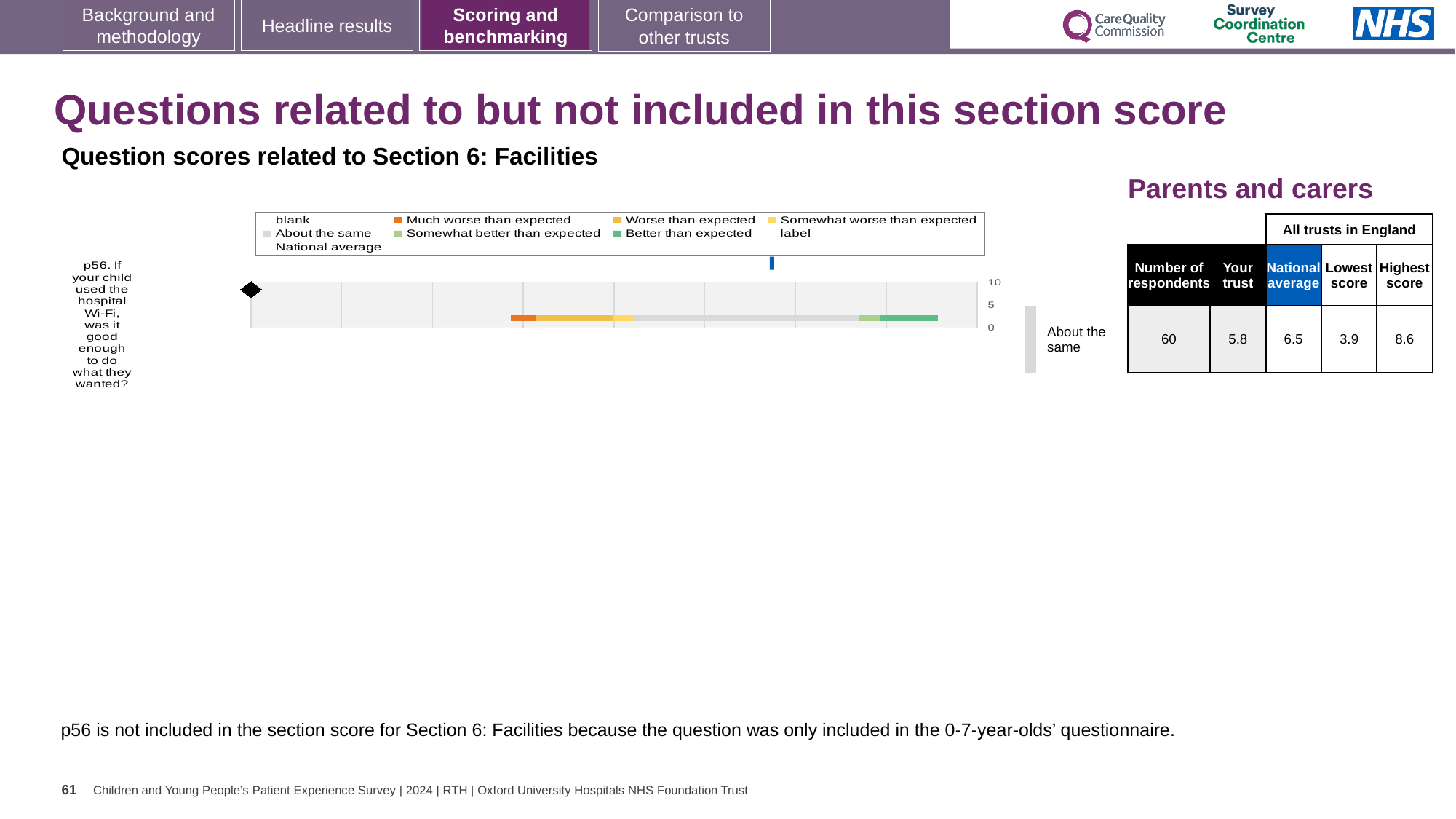
What is the national average score for p56 shown in the table beside the chart? 6.5 What is the 'Your trust' score for p56 shown in the table beside the chart? 5.8 What is the highest score among all trusts in England for p56? 8.6 How many respondents answered p56? 60 What is the difference between the highest and lowest scores for p56 across all trusts in England? 4.7 What colour does the legend use for 'Much worse than expected'? orange How many questions (categories) are plotted in the chart? 1 What kind of chart is shown on the slide? bar chart What is the difference between the national average and the 'Your trust' score for p56? 0.7 Which is larger for p56, the 'Your trust' score or the national average? national average Which question is plotted in the chart? p56. If your child used the hospital Wi-Fi, was it good enough to do what they wanted? What is the lowest score among all trusts in England for p56? 3.9